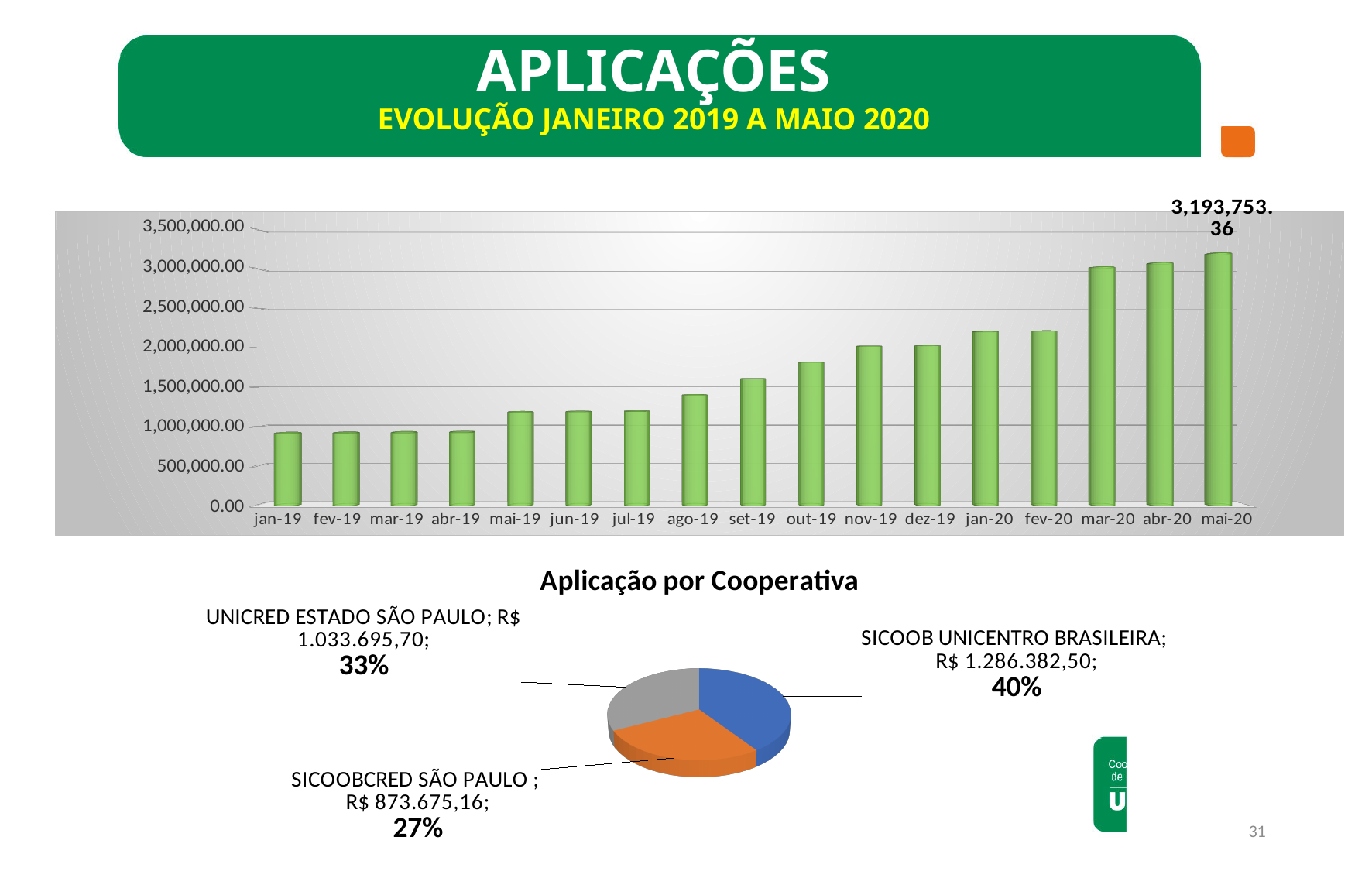
In the 'Aplicação por Cooperativa' pie chart, how many slices are there? 3 What kind of chart is the top chart on the slide? bar chart In the top bar chart, do the values generally rise or fall from jan-19 to mai-20? rise In the top bar chart, which is larger, the value for set-19 or the value for jun-19? set-19 In the top bar chart, is the value for mar-20 greater or less than 2,500,000.00? greater In the top bar chart, what is the value for mai-20? 3,193,753.36 In the 'Aplicação por Cooperativa' pie chart, which cooperative has the smallest slice? SICOOBCRED SÃO PAULO In the top bar chart, how many months are shown on the x axis? 17 In the top bar chart, is the value for jan-19 greater or less than 1,000,000.00? less In the 'Aplicação por Cooperativa' pie chart, what share does SICOOBCRED SÃO PAULO have? 27% In the top bar chart, which month has the highest value? mai-20 In the 'Aplicação por Cooperativa' pie chart, what is the value for SICOOB UNICENTRO BRASILEIRA? R$ 1.286.382,50